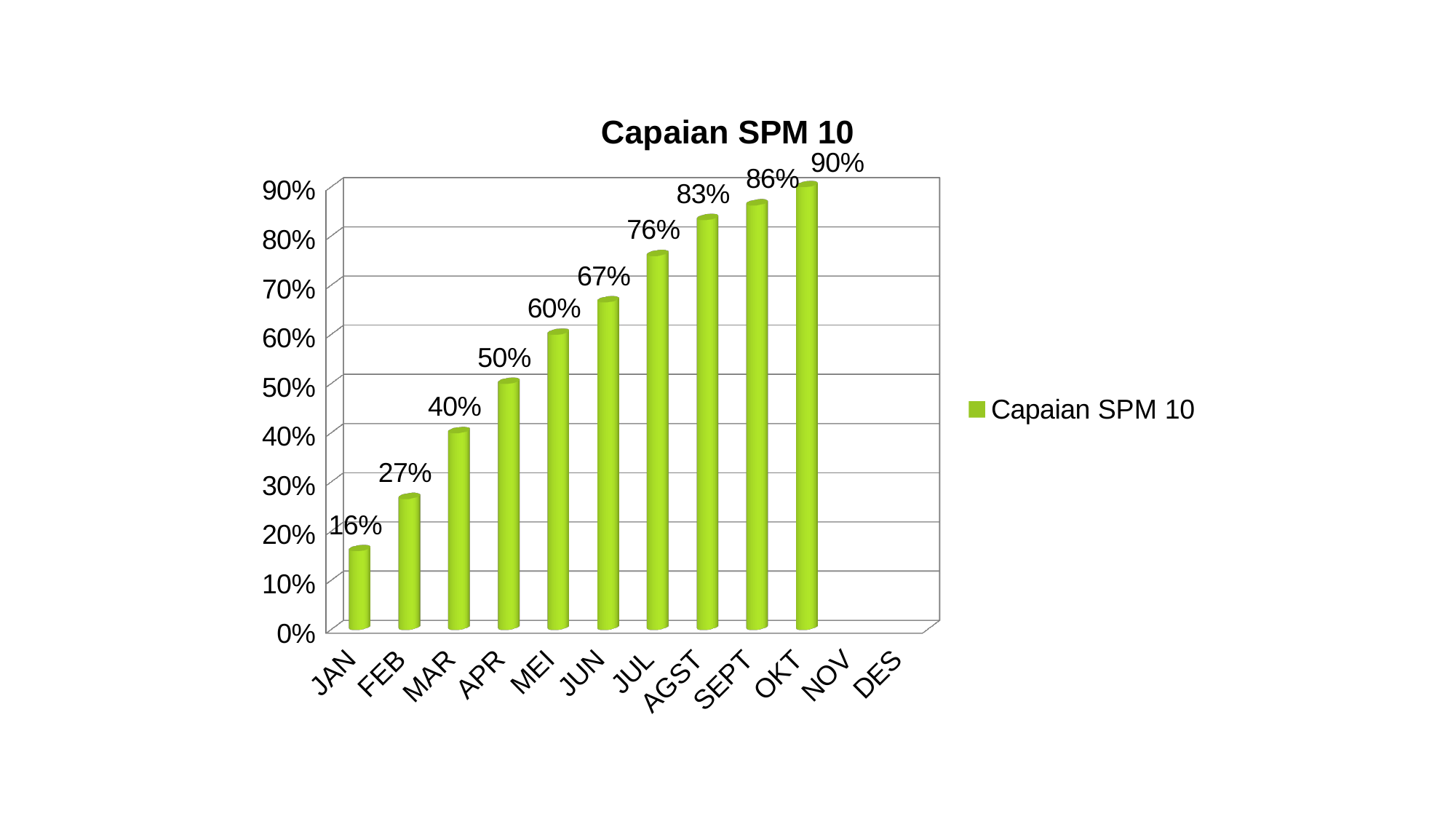
What is the difference between the values for JUN and MEI? 7% How many series does the legend list? 1 What is the value for JAN? 16% What is the difference between the values for OKT and JAN? 74% Do the values rise or fall from JAN to OKT? rise How many months have bars plotted? 10 What is the value for MAR? 40% Which month has the lowest value among those with bars? JAN Which month has the highest value? OKT What is the value for JUL? 76% Which is larger, the value for APR or the value for FEB? APR What kind of chart is this? bar chart